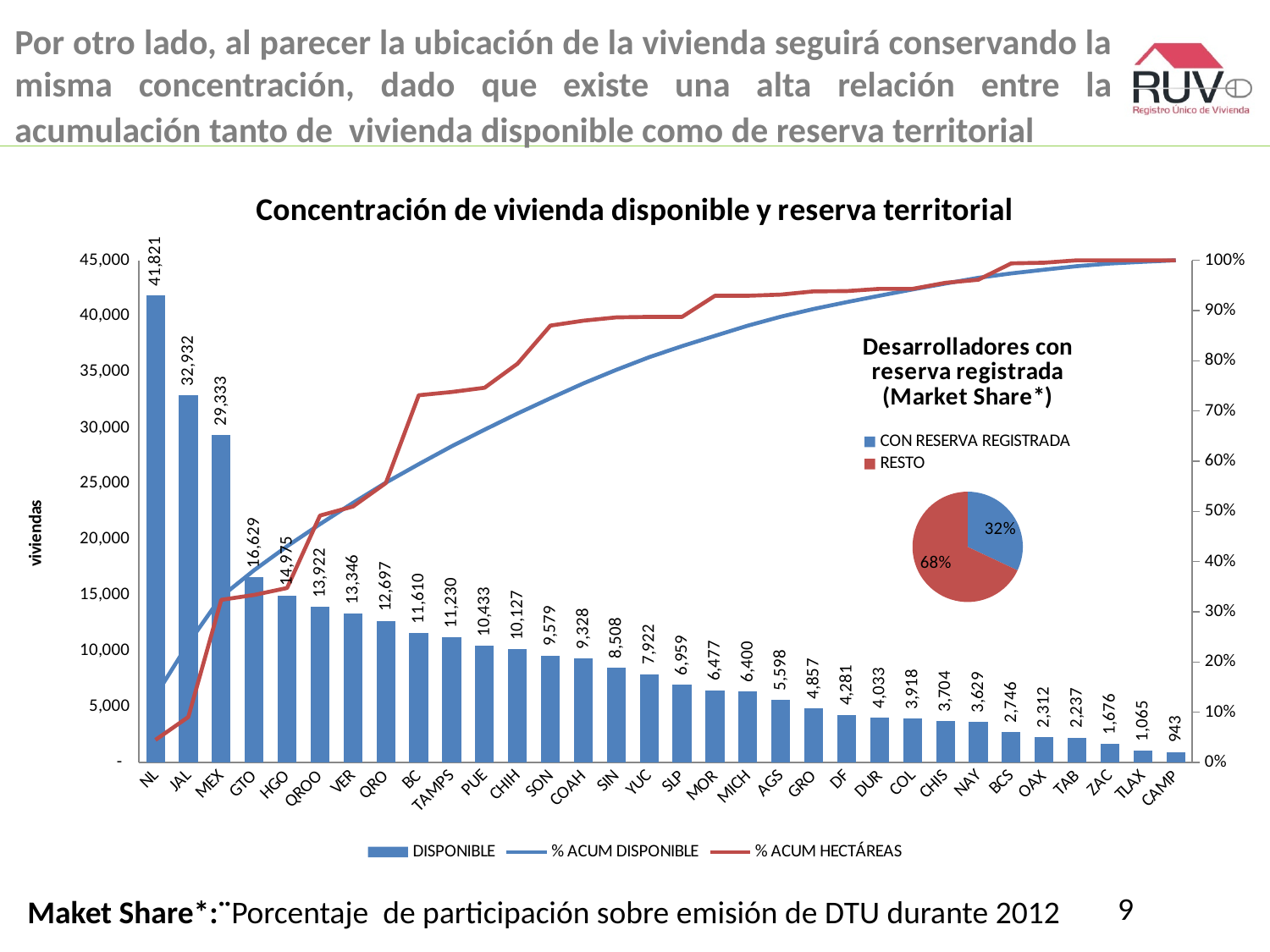
In the chart 'Concentración de vivienda disponible y reserva territorial', do the DISPONIBLE bar values rise or fall from left to right along the x axis? fall In the chart 'Concentración de vivienda disponible y reserva territorial', how many states are shown on the x axis? 32 In the chart 'Desarrolladores con reserva registrada (Market Share*)', what share does RESTO have? 68% What kind of chart is 'Desarrolladores con reserva registrada (Market Share*)'? pie chart In the chart 'Concentración de vivienda disponible y reserva territorial', what is the DISPONIBLE value for GTO? 16,629 In the chart 'Concentración de vivienda disponible y reserva territorial', how many series does the legend list? 3 In the chart 'Concentración de vivienda disponible y reserva territorial', what is the difference between the DISPONIBLE values for JAL and MEX? 3,599 In the chart 'Concentración de vivienda disponible y reserva territorial', which state has the highest DISPONIBLE value? NL In the chart 'Desarrolladores con reserva registrada (Market Share*)', what share does CON RESERVA REGISTRADA have? 32% In the chart 'Concentración de vivienda disponible y reserva territorial', which state has the lowest DISPONIBLE value? CAMP In the chart 'Concentración de vivienda disponible y reserva territorial', which has a larger DISPONIBLE value, VER or QRO? VER In the chart 'Concentración de vivienda disponible y reserva territorial', what is the DISPONIBLE value for NL? 41,821